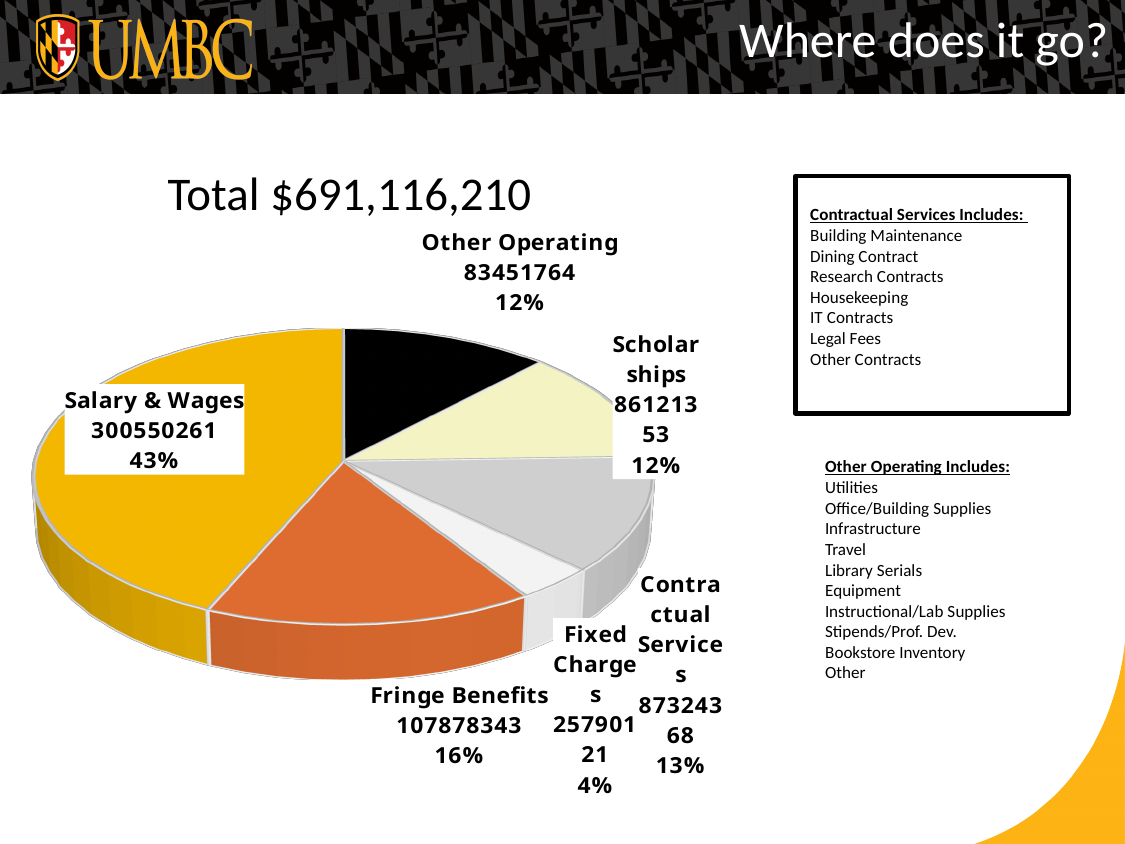
What is the value shown for Salary & Wages? 300550261 How many categories are shown in the pie chart? 6 What total amount is stated in the chart title? $691,116,210 What is the difference between the values for Fringe Benefits and Fixed Charges? 82088222 Which is larger, the value for Contractual Services or the value for Other Operating? Contractual Services What percentage share does Fringe Benefits have? 16% What is the value shown for Contractual Services? 87324368 What percentage share does Fixed Charges have? 4% Which category has the largest slice of the pie? Salary & Wages What percentage share does Scholarships have? 12% What kind of chart is shown on the slide? pie chart Which category has the smallest slice of the pie? Fixed Charges